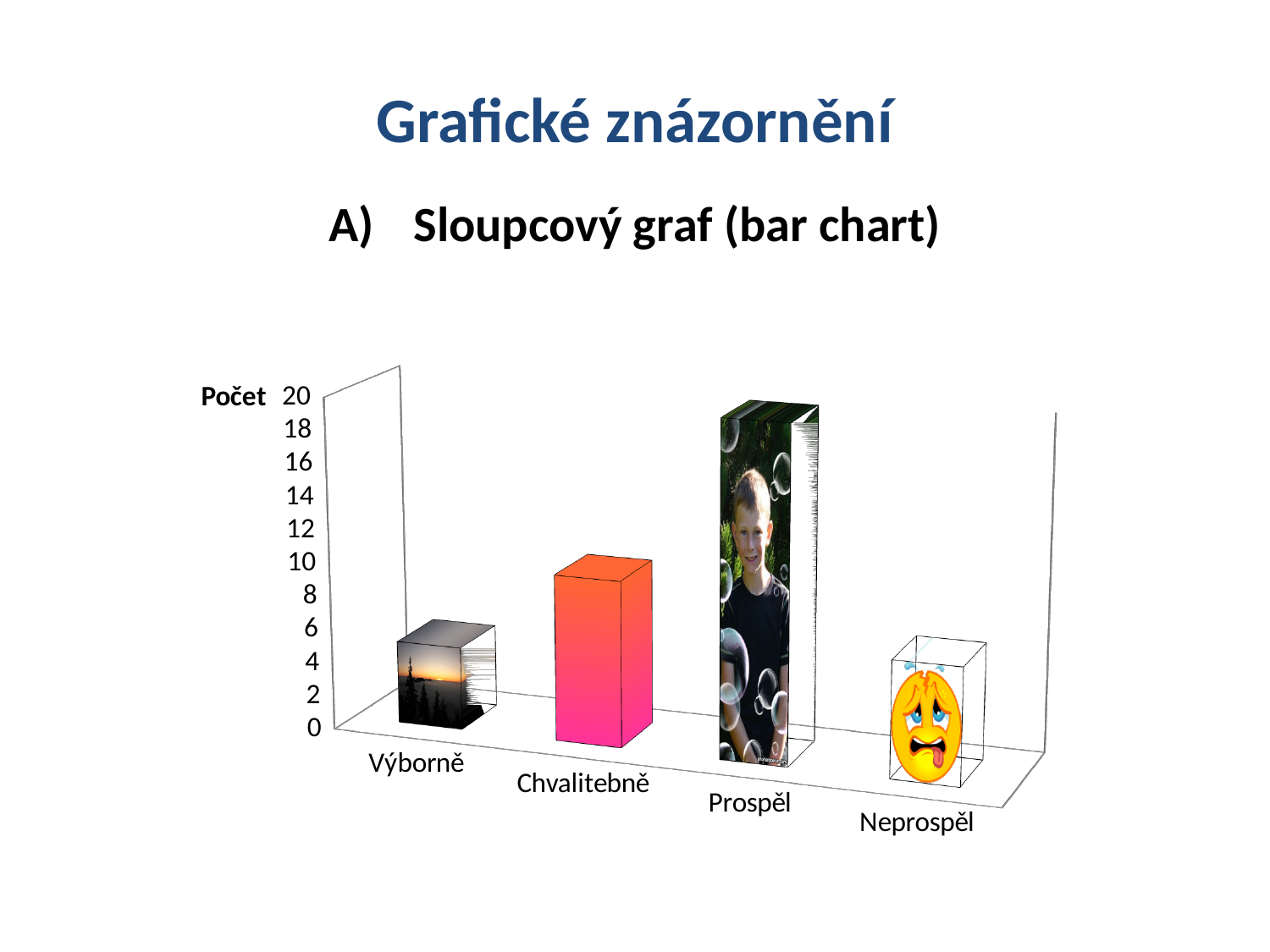
Which category has the highest bar in the chart? Prospěl Is the value for Neprospěl greater or less than 12? less Is the value for Chvalitebně greater or less than 6? greater What kind of chart is shown on the slide? bar chart What is the label of the vertical axis of the chart? Počet Which is larger, the value for Prospěl or the value for Chvalitebně? Prospěl Which is larger, the value for Chvalitebně or the value for Neprospěl? Chvalitebně What is the highest tick value shown on the vertical axis of the chart? 20 Is the value for Prospěl greater or less than 14? greater How many categories are shown on the x axis of the chart? 4 Which is larger, the value for Chvalitebně or the value for Výborně? Chvalitebně